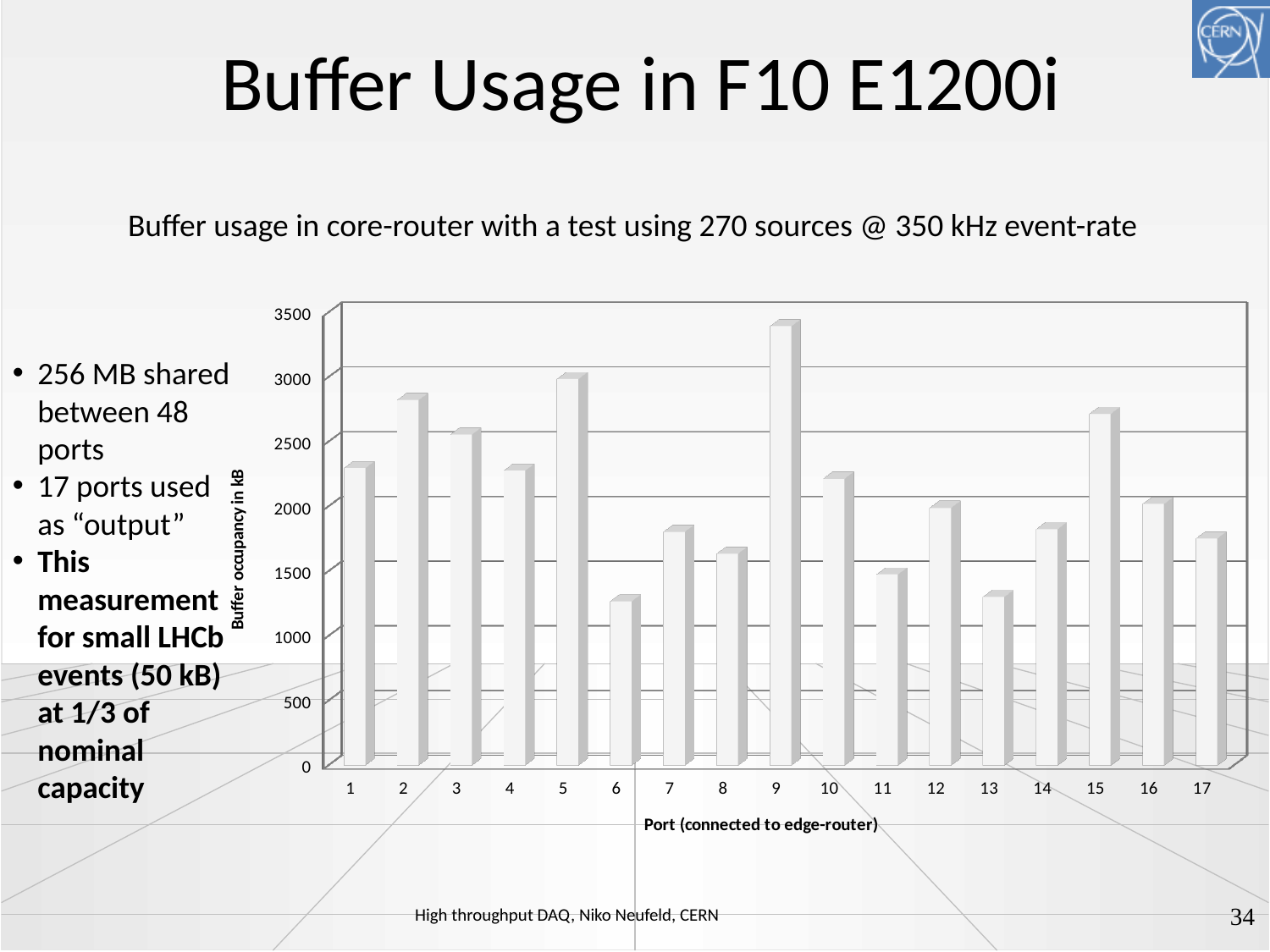
Which port has the highest buffer occupancy? 9 Which port has the larger buffer occupancy, port 9 or port 6? 9 Which port has the larger buffer occupancy, port 8 or port 5? 5 What is the label of the horizontal axis of the chart? Port (connected to edge-router) What kind of chart is shown on the slide? bar chart How many ports are plotted on the x axis of the chart? 17 Is the buffer occupancy for port 5 greater or less than 2500? greater Is the buffer occupancy for port 6 greater or less than 1500? less Is the buffer occupancy for port 15 greater or less than 2500? greater What is the label of the vertical axis of the chart? Buffer occupancy in kB